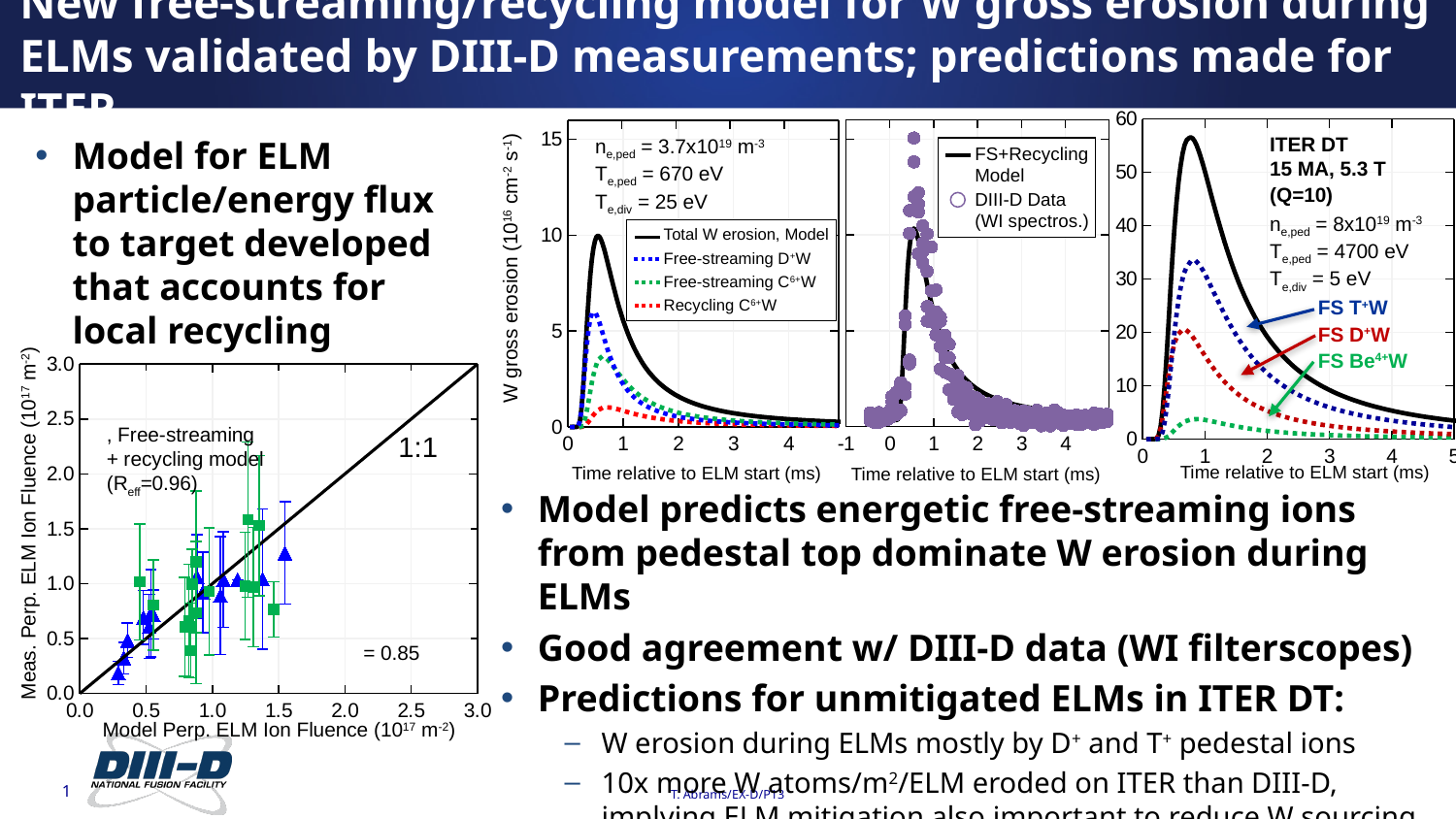
In the ITER DT chart on the right, is the peak of the solid black curve greater or less than 50? greater In the ITER DT chart on the right, which curve peaks higher: FS T+W or FS D+W? FS T+W In the W gross erosion chart with the legend 'Total W erosion, Model', is the peak value of the Total W erosion curve greater or less than 5? greater In the W gross erosion chart with the legend 'Total W erosion, Model', which peaks higher: Free-streaming D+W or Free-streaming C6+W? Free-streaming D+W What kind of chart is the bottom-left chart of measured vs model perpendicular ELM ion fluence? scatter plot In the W gross erosion chart with the legend 'Total W erosion, Model', how many series does the legend list? 4 In the W gross erosion chart with the legend 'Total W erosion, Model', does the Total W erosion curve rise or fall between 1 ms and 4 ms? fall In the ITER DT chart on the right, is the peak of the FS Be4+W curve greater or less than 10? less In the bottom-left chart of measured vs model perpendicular ELM ion fluence, what is the maximum value shown on the x axis? 3.0 In the bottom-left chart of measured vs model perpendicular ELM ion fluence, what R_eff value is given for the free-streaming + recycling model? R_eff=0.96 In the middle chart comparing the FS+Recycling Model with DIII-D Data, how many series does the legend list? 2